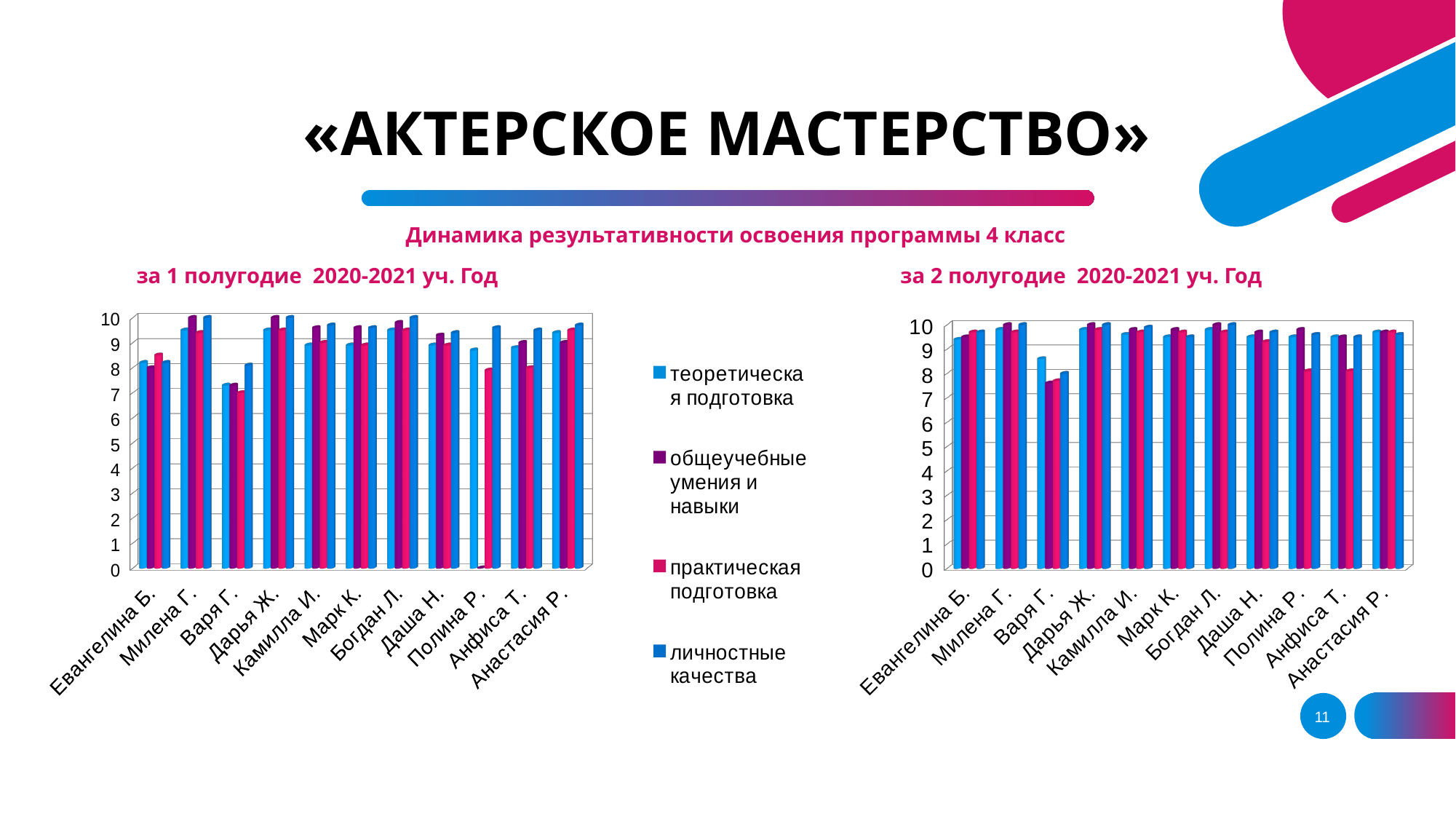
What kind of chart is used for "за 1 полугодие 2020-2021 уч. Год"? Bar chart In the chart "за 1 полугодие 2020-2021 уч. Год", which student has the lowest value for практическая подготовка? Варя Г. In the chart "за 1 полугодие 2020-2021 уч. Год", is the value of теоретическая подготовка for Варя Г. greater or less than 8? less In the chart "за 1 полугодие 2020-2021 уч. Год", which student has the larger value for теоретическая подготовка: Варя Г. or Милена Г.? Милена Г. How many students (categories) are shown on the x axis of the chart "за 2 полугодие 2020-2021 уч. Год"? 11 In the chart "за 2 полугодие 2020-2021 уч. Год", is the value of практическая подготовка for Полина Р. greater or less than 9? less Which series is shown in red (pink) in the legend? практическая подготовка In the chart "за 1 полугодие 2020-2021 уч. Год", is the value of практическая подготовка for Полина Р. greater or less than 5? greater In the chart "за 2 полугодие 2020-2021 уч. Год", which student has the larger value for личностные качества: Варя Г. or Дарья Ж.? Дарья Ж. How many series does the legend list for the charts? 4 In the chart "за 2 полугодие 2020-2021 уч. Год", which student has the lowest value for теоретическая подготовка? Варя Г.